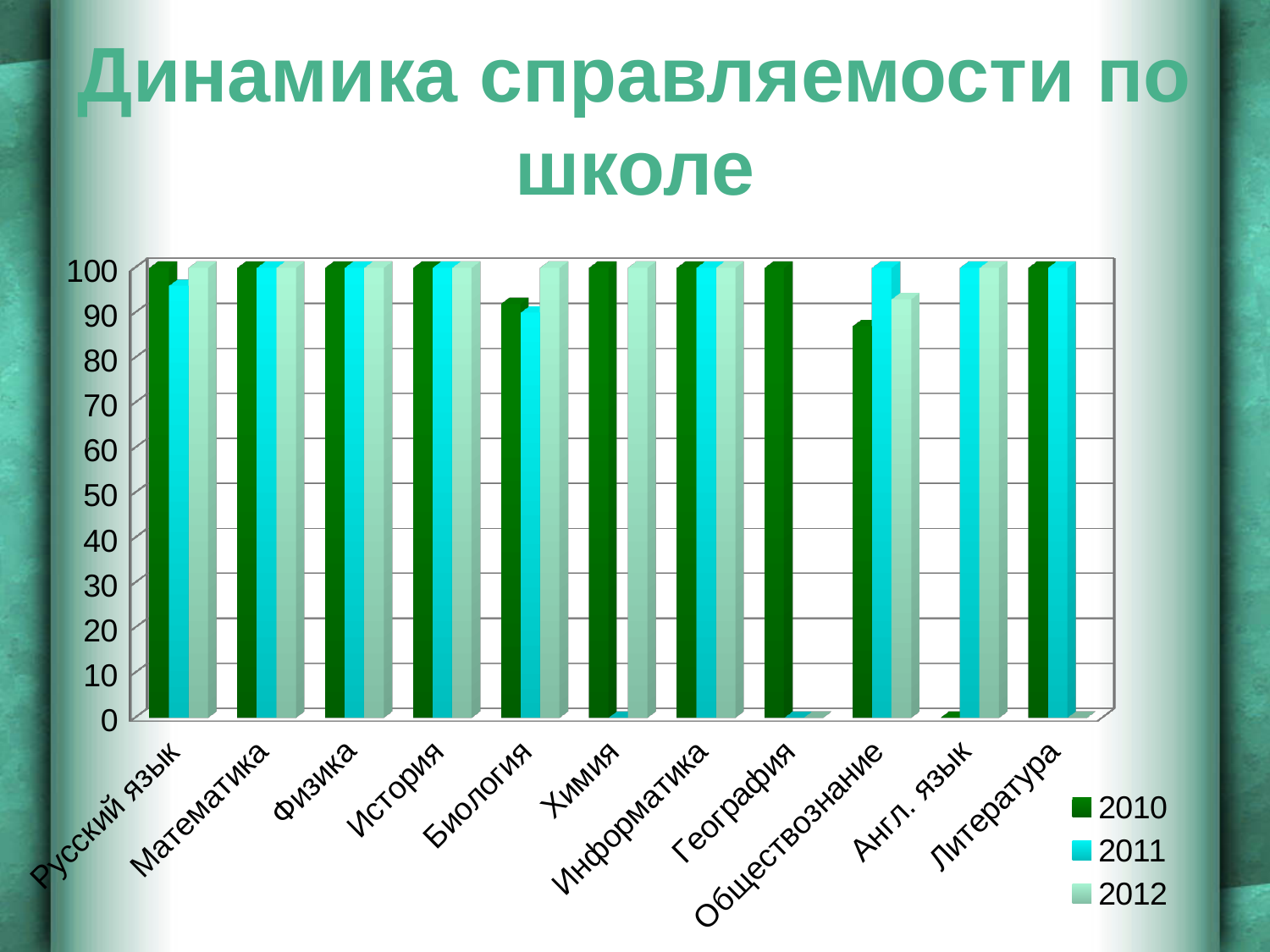
Is the 2010 value for Биология greater or less than 80? greater For Обществознание, which is larger: the 2010 value or the 2011 value? 2011 How many series does the chart legend list? 3 What type of chart is shown on the slide? bar chart How many subject categories are shown on the x axis of the chart? 11 Is the 2012 value for Обществознание greater or less than 80? greater What is the title of the chart slide? Динамика справляемости по школе For Русский язык, which is larger: the 2010 value or the 2011 value? 2010 Is the 2011 value for Русский язык greater or less than 90? greater What are the series names listed in the chart legend? 2010, 2011, 2012 For Биология, which is larger: the 2011 value or the 2012 value? 2012